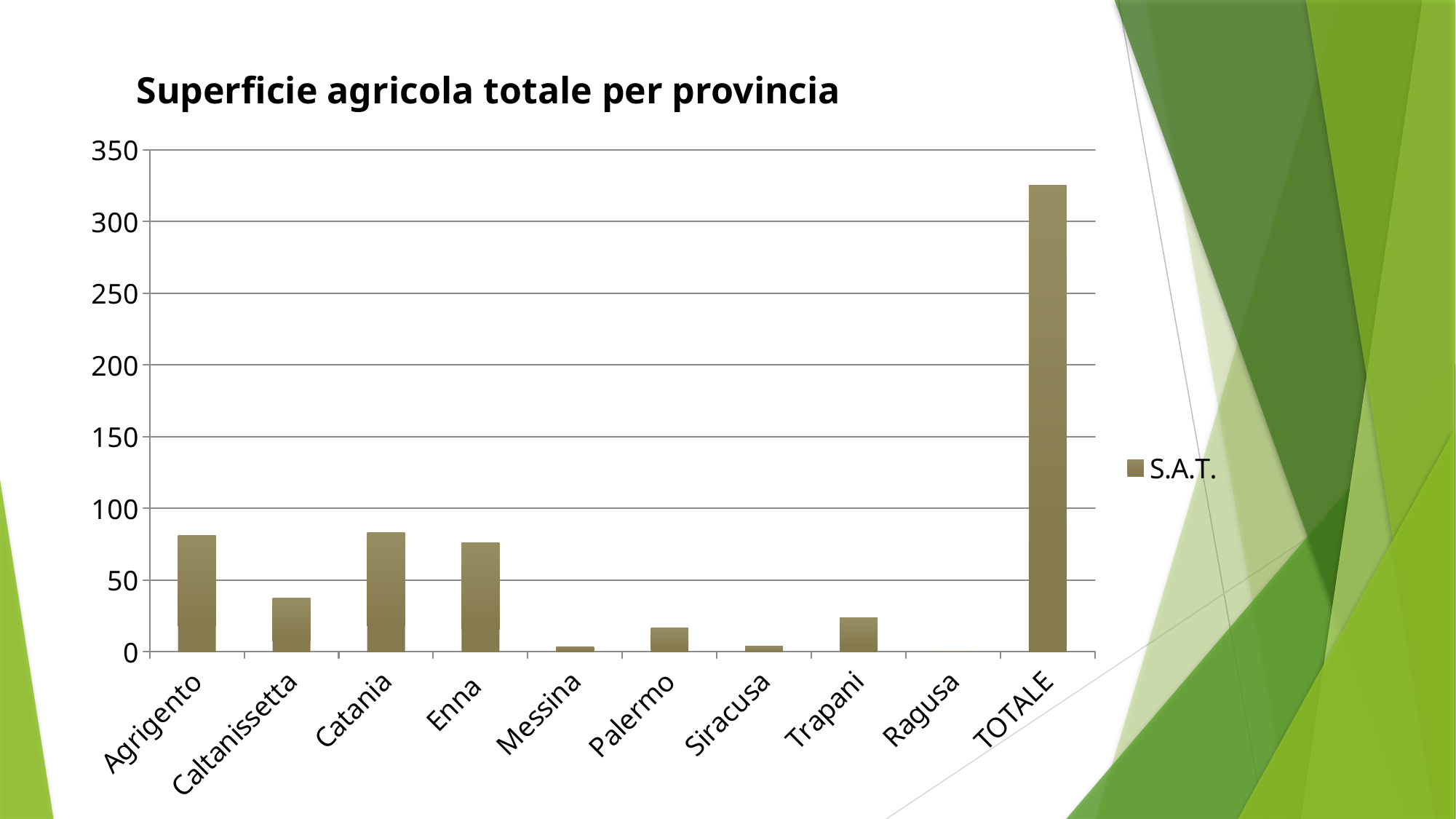
What is the title of the chart? Superficie agricola totale per provincia How many series does the legend list? 1 Is the value for Enna greater or less than 50? greater What kind of chart is shown on the slide? bar chart Which is larger, the value for Agrigento or the value for Caltanissetta? Agrigento How many categories are shown on the x axis? 10 Which category has the highest bar? TOTALE Which category has the lowest value (no visible bar)? Ragusa Which is larger, the value for Trapani or the value for Enna? Enna What is the name of the series shown in the legend? S.A.T. Is the value for TOTALE greater or less than 300? greater Is the value for Caltanissetta greater or less than 50? less